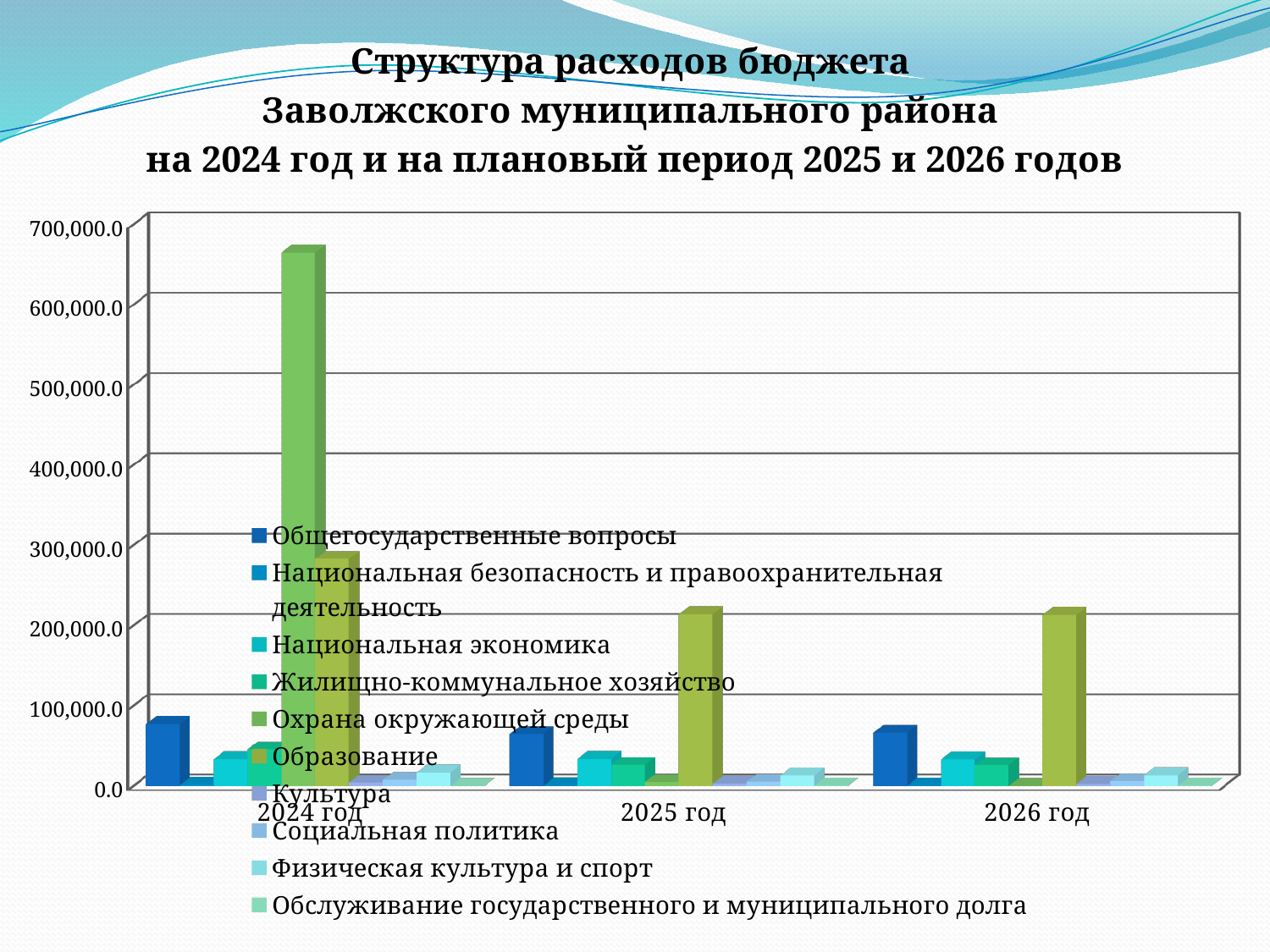
Does the value for Образование rise or fall from 2024 год to 2025 год? fall Is the value for Охрана окружающей среды in 2024 год greater or less than 600,000.0? greater What kind of chart is shown on the slide? bar chart In the 2025 год group, which is larger: Образование or Общегосударственные вопросы? Образование What is the highest value labelled on the chart's vertical axis? 700,000.0 Which year has the tallest bar in the chart? 2024 год Which series has the tallest bar in the 2024 год group? Охрана окружающей среды Is the value for Образование in 2025 год greater or less than 300,000.0? less Is the value for Общегосударственные вопросы in 2024 год greater or less than 100,000.0? less How many series does the chart's legend list? 10 How many year categories are shown on the x axis of the chart? 3